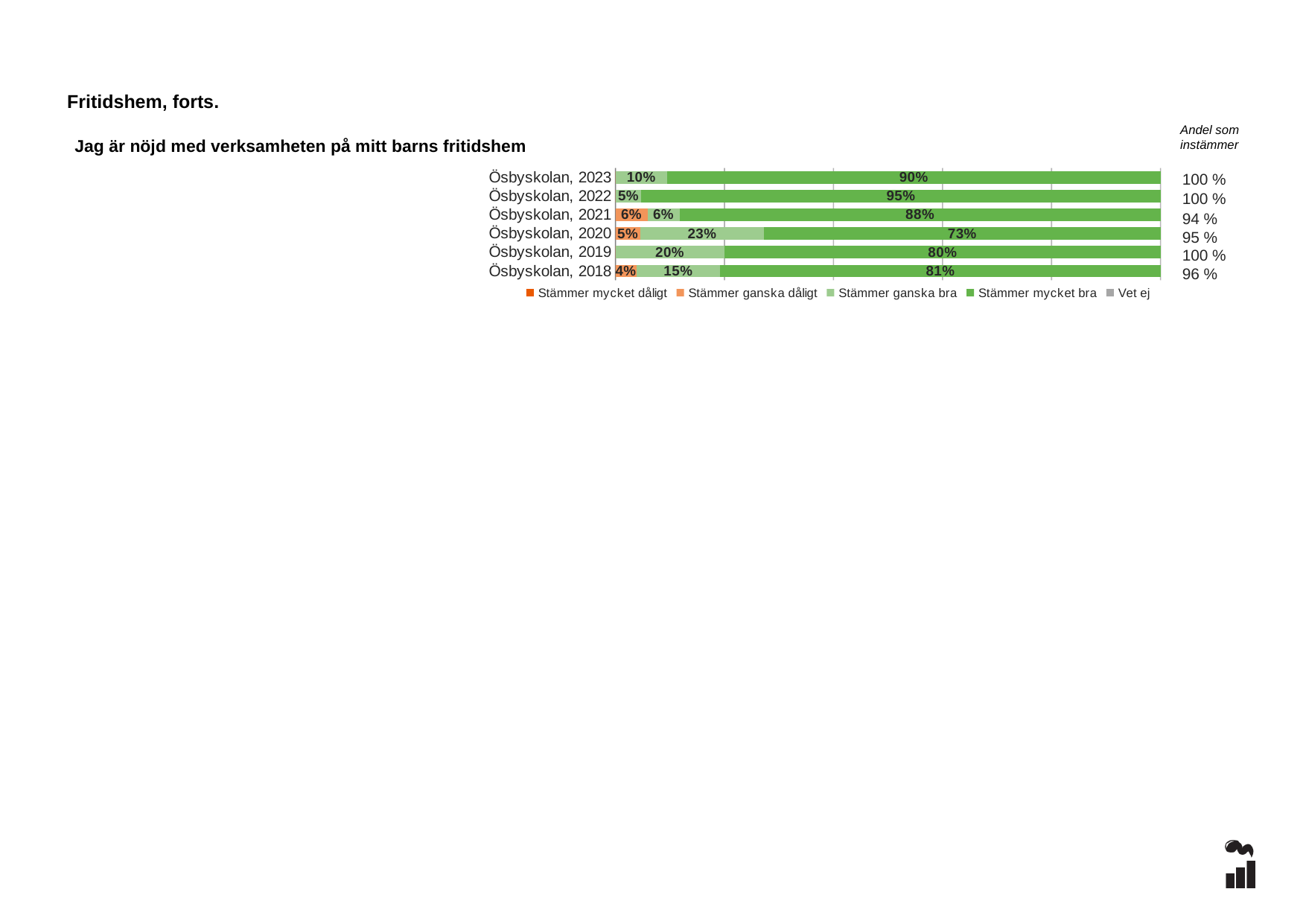
How many categories (bars) are shown in the chart? 6 Which is larger: the 'Stämmer ganska bra' value for Ösbyskolan, 2019 or for Ösbyskolan, 2018? Ösbyskolan, 2019 Which year has the lowest 'Stämmer mycket bra' value? Ösbyskolan, 2020 What is the 'Stämmer mycket bra' value for Ösbyskolan, 2023? 90% What is the 'Andel som instämmer' value shown for Ösbyskolan, 2021? 94 % What is the 'Stämmer ganska bra' value for Ösbyskolan, 2020? 23% What is the title of the chart? Jag är nöjd med verksamheten på mitt barns fritidshem What is the 'Stämmer ganska dåligt' value for Ösbyskolan, 2018? 4% What is the difference between the 'Stämmer mycket bra' values for Ösbyskolan, 2022 and Ösbyskolan, 2021? 7% What kind of chart is shown on the slide? Stacked bar chart How many series does the legend list? 5 Which year has the highest 'Stämmer mycket bra' value? Ösbyskolan, 2022